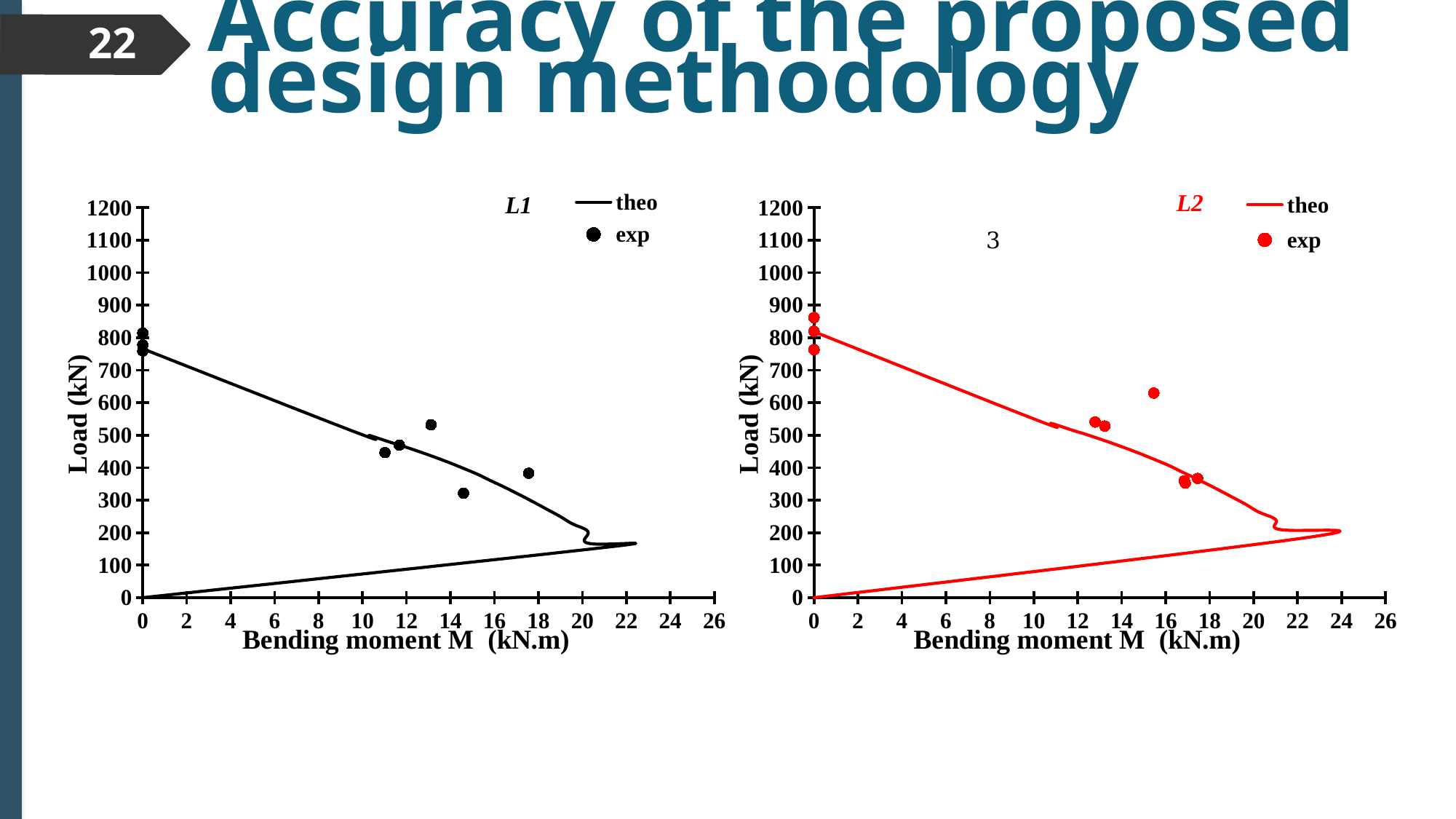
In the right chart (L2), does the load on the theo line rise or fall as the bending moment increases from 0 to 20 kN.m? fall In the left chart (L1), is the largest bending moment reached by the theo line greater or less than 20? greater What is the y-axis title of the right chart (L2)? Load (kN) What is the x-axis title of the left chart (L1)? Bending moment M (kN.m) In the left chart (L1), is the load of the exp point near a bending moment of 13 kN.m greater or less than 500? greater In the right chart (L2), is the largest bending moment reached by the theo line greater or less than 22? greater What kind of chart is the left chart labelled L1? Scatter chart with a line How many series does the legend of the right chart (L2) list? 2 Which chart's theo line reaches a larger maximum bending moment, L1 or L2? L2 What is the highest value shown on the y axis of the left chart (L1)? 1200